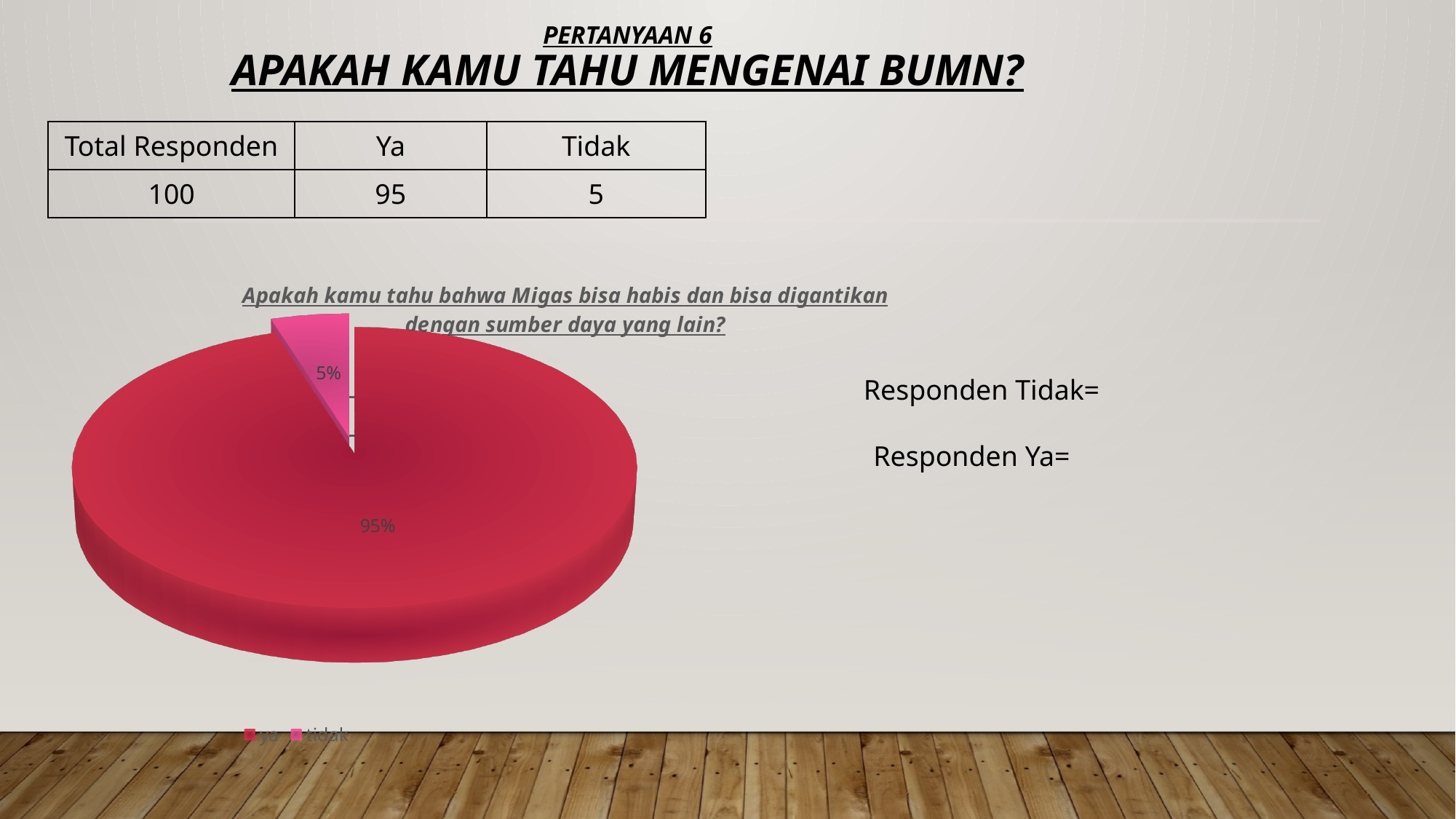
Which slice of the pie chart is the smallest? tidak What kind of chart is shown on the slide? pie chart How many slices does the pie chart have? 2 What share of the pie does the "ya" slice represent? 95% What is the difference in percentage points between the "ya" and "tidak" slices? 90 What share of the pie does the "tidak" slice represent? 5% What are the two legend entries of the pie chart? ya, tidak What colour is the "tidak" slice in the pie chart? pink Which is larger in the pie chart, the "ya" slice or the "tidak" slice? ya How many entries does the chart legend list? 2 Which slice of the pie chart is the largest? ya